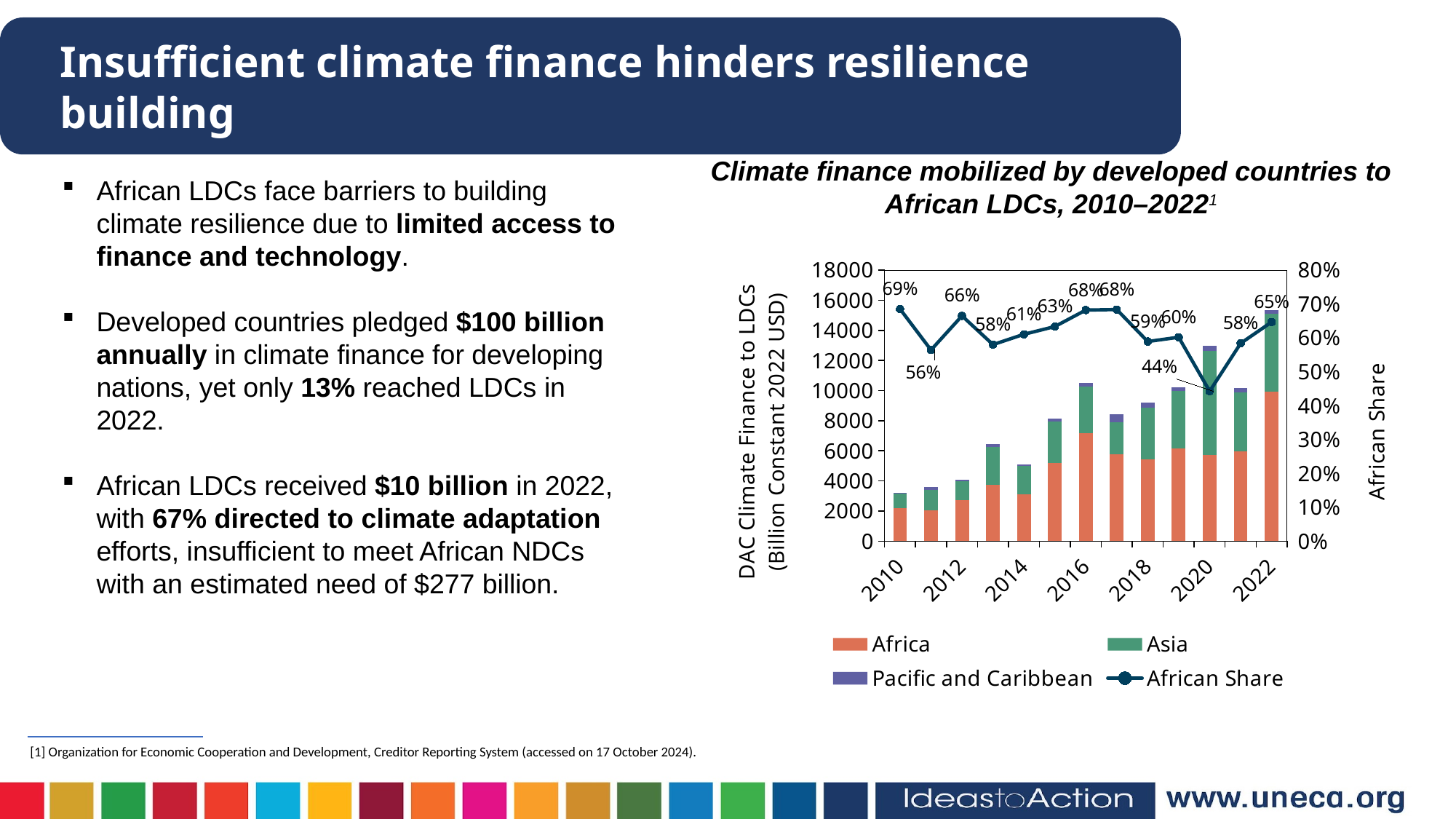
How many series does the legend list? 4 What is the African Share value shown for 2022? 65% Which year has the larger African Share, 2012 or 2013? 2012 What is the African Share value shown for 2010? 69% What is the African Share value shown for 2020? 44% Is the total height of the stacked bar for 2022 greater or less than 14000? greater In which year is the African Share at its highest? 2010 What kind of chart is this? Stacked bar chart combined with a line chart How many years are shown on the x axis of the chart? 7 Is the total height of the stacked bar for 2010 greater or less than 4000? less In which year is the African Share at its lowest? 2020 By how many percentage points does the African Share in 2010 exceed the African Share in 2020? 25 percentage points